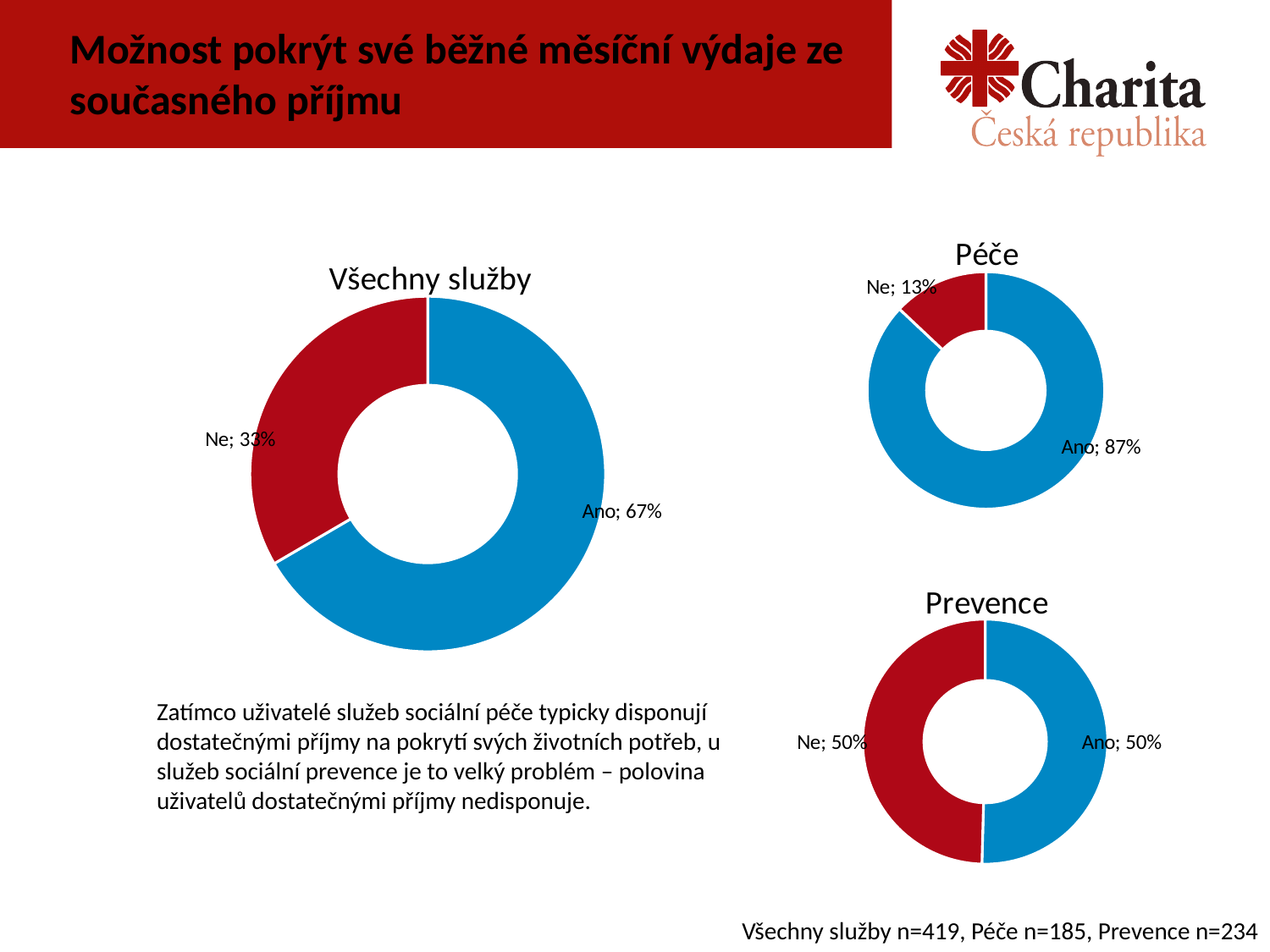
In the 'Všechny služby' chart, which category is the smallest? Ne In the 'Péče' chart, which category is the largest? Ano In the 'Všechny služby' chart, which is larger, 'Ano' or 'Ne'? Ano In the 'Prevence' chart, what is the value for 'Ne'? 50% In the 'Péče' chart, what is the value for 'Ano'? 87% How many charts are shown on the slide? 3 In the 'Péče' chart, what is the difference between 'Ano' and 'Ne'? 74% In the 'Všechny služby' chart, what is the value for 'Ne'? 33% How many slices does the 'Prevence' chart have? 2 What kind of chart is the 'Všechny služby' chart? Doughnut chart In the 'Všechny služby' chart, what is the value for 'Ano'? 67% In the 'Péče' chart, what is the value for 'Ne'? 13%